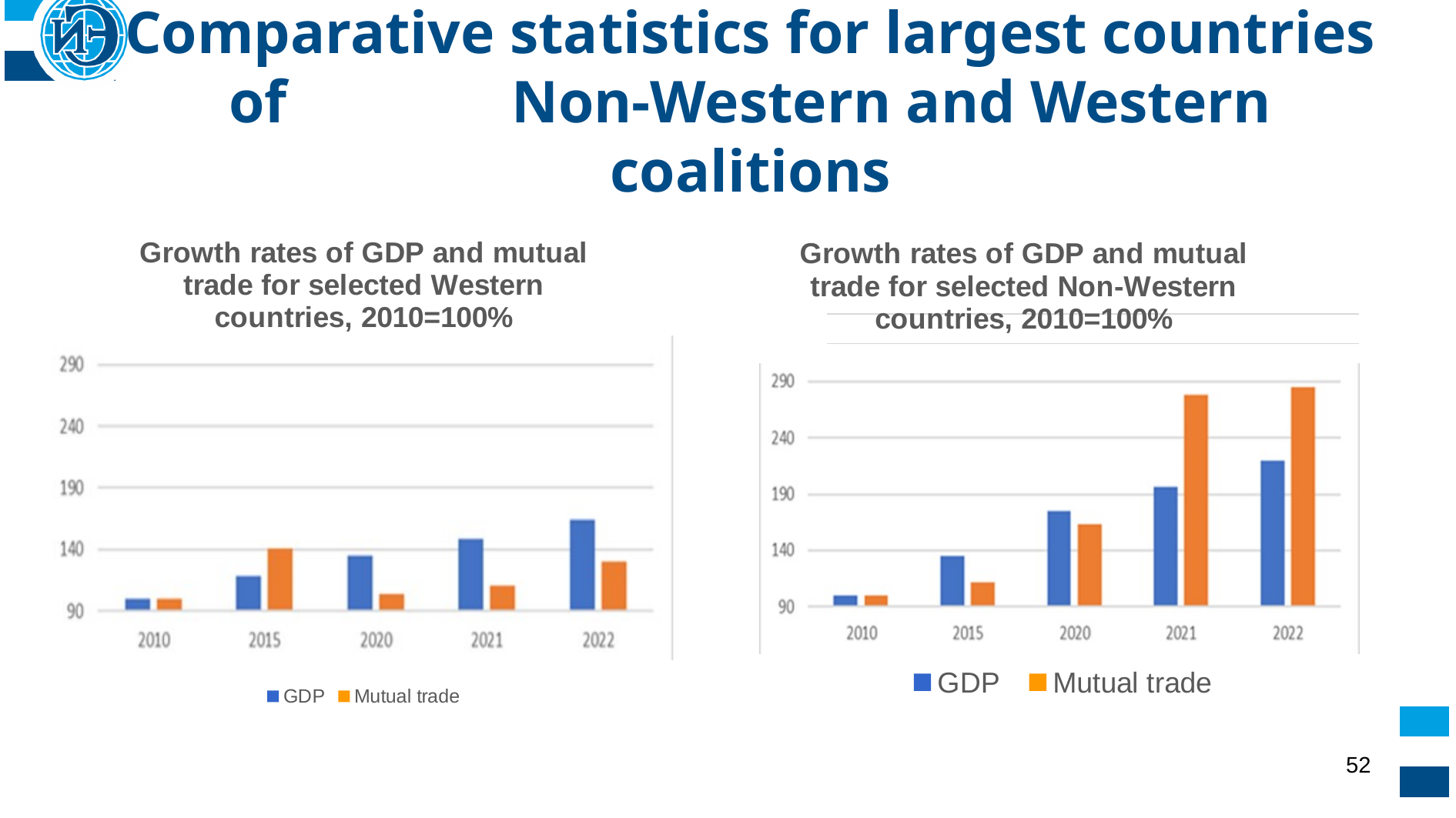
What kind of chart is the 'Growth rates of GDP and mutual trade for selected Western countries, 2010=100%' chart? Bar chart How many series does the legend of the Western countries chart list? 2 In the Western countries chart, which is larger in 2020, GDP or Mutual trade? GDP In the Non-Western countries chart, does the GDP series rise or fall from 2010 to 2022? Rise In the Western countries chart, which year has the highest Mutual trade value? 2015 In the Non-Western countries chart, is the Mutual trade value for 2021 greater or less than 240? greater In the Non-Western countries chart, which year has the highest Mutual trade value? 2022 In the Western countries chart, is the GDP value for 2022 greater or less than 190? less How many years are shown on the x axis of the Non-Western countries chart? 5 In the Non-Western countries chart, is the GDP value for 2022 greater or less than 190? greater In the Western countries chart, which year has the highest GDP value? 2022 In the Non-Western countries chart, which is larger in 2021, GDP or Mutual trade? Mutual trade